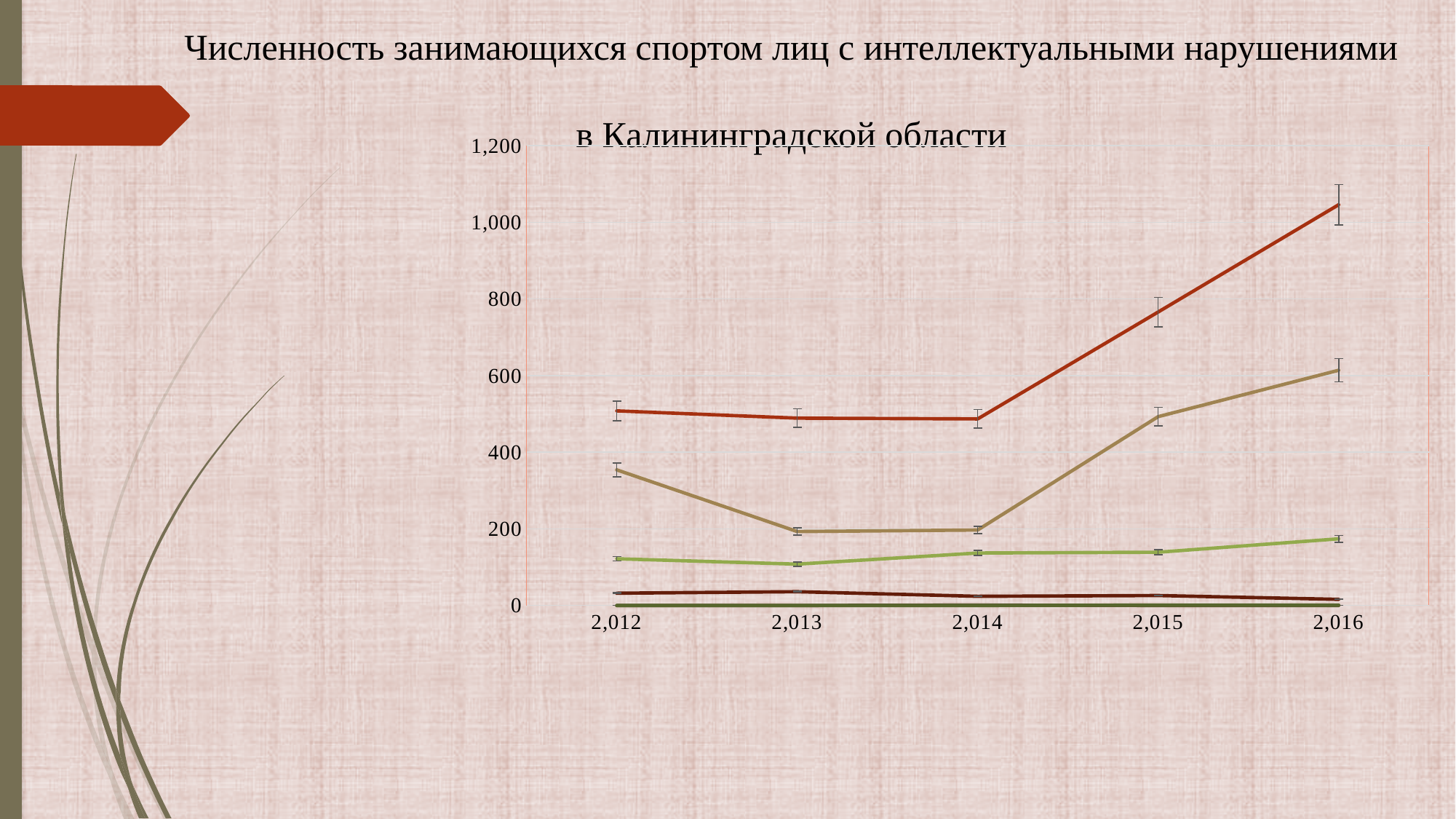
Is the value of the red line in 2,012 greater or less than 400? greater What is the highest value labelled on the y axis? 1,200 Is the value of the light green line in 2,016 greater or less than 200? less How many years are shown along the x axis of the chart? 5 Is the value of the tan (light brown) line in 2,013 greater or less than 400? less What kind of chart is shown on the slide? line chart In 2,016, which is larger: the value of the red line or the value of the tan (light brown) line? the red line What is the first year shown on the x axis? 2,012 Does the red line rise or fall between 2,014 and 2,016? rise In which year does the red line reach its highest value? 2,016